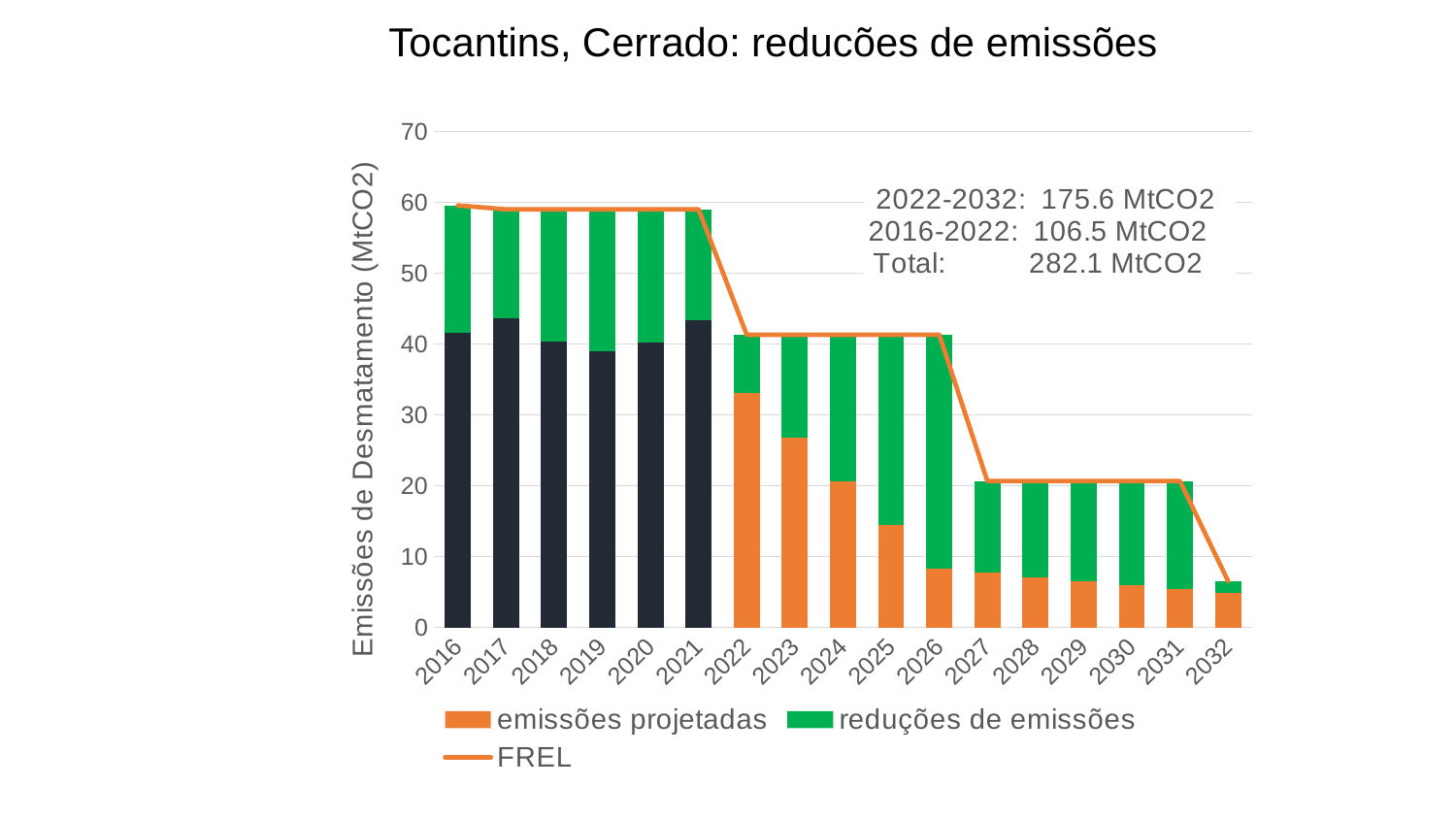
Is the FREL value for 2018 greater or less than 50? greater According to the text on the chart, what is the emission reduction for 2022-2032? 175.6 MtCO2 What kind of chart is shown on the slide? Stacked bar chart with a line How many years are shown on the x axis? 17 Does the FREL line rise or fall along the x axis from 2016 to 2032? fall According to the text on the chart, what is the total emission reduction? 282.1 MtCO2 What is the title of the chart? Tocantins, Cerrado: reducões de emissões According to the text on the chart, what is the emission reduction for 2016-2022? 106.5 MtCO2 How many series does the legend list? 3 What is the y-axis label of the chart? Emissões de Desmatamento (MtCO2) Is the value of emissões projetadas for 2022 greater or less than 30? greater